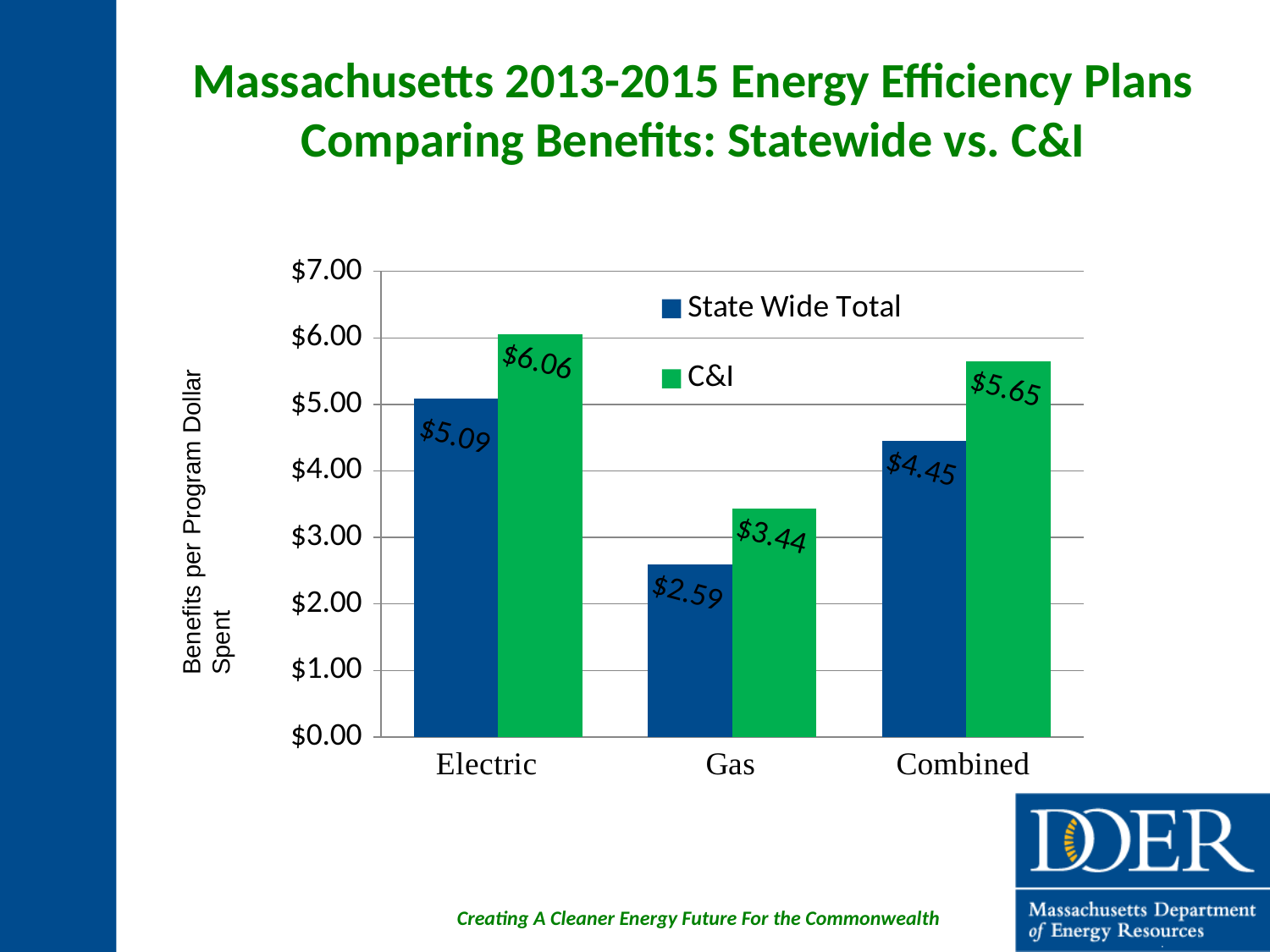
Which category has the lowest State Wide Total value? Gas Which is larger for Gas, the State Wide Total value or the C&I value? C&I What is the C&I value for Combined? $5.65 How many series does the legend list? 2 How many categories are shown on the x axis? 3 What is the difference between the C&I and State Wide Total values for Combined? $1.20 What is the State Wide Total value for Electric? $5.09 What is the State Wide Total value for Gas? $2.59 What kind of chart is shown on the slide? Bar chart What is the difference between the C&I and State Wide Total values for Electric? $0.97 Which category has the highest C&I value? Electric What is the C&I value for Gas? $3.44